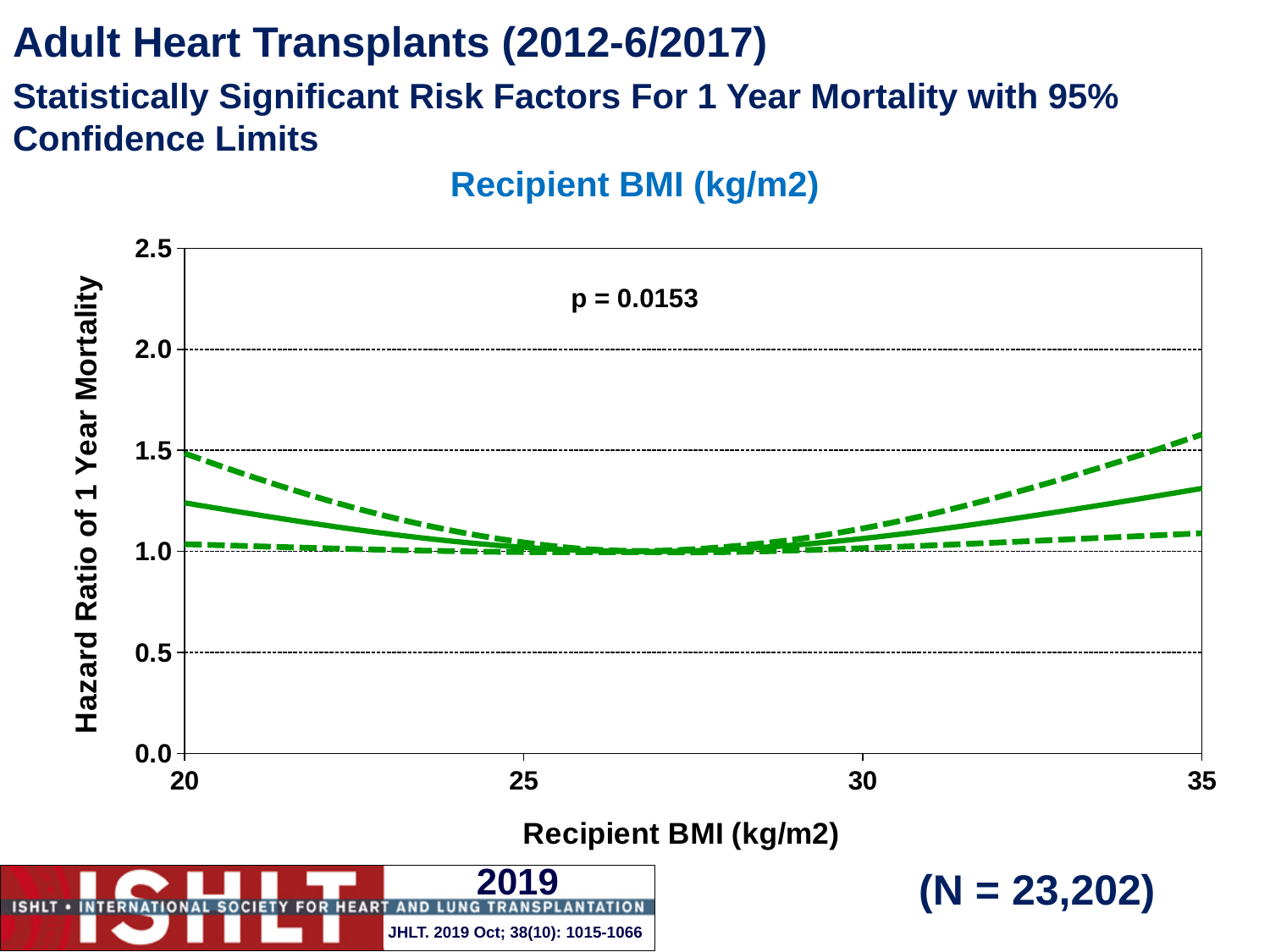
Is the hazard ratio (solid line) at a recipient BMI of 25 greater or less than 1.5? less What kind of chart is shown on the slide? Line chart How many lines are plotted on the chart? 3 Is the hazard ratio (solid line) at a recipient BMI of 35 greater or less than 1.5? less Does the hazard ratio (solid line) rise or fall as recipient BMI increases from 30 to 35? rise How many tick labels are shown on the x axis? 4 What p-value is printed on the chart? p = 0.0153 Does the hazard ratio (solid line) rise or fall as recipient BMI increases from 20 to 25? fall What is the sample size (N) shown on the slide? N = 23,202 What is the label of the y axis? Hazard Ratio of 1 Year Mortality Is the hazard ratio (solid line) at a recipient BMI of 20 greater or less than 1.0? greater What is the title of the chart? Recipient BMI (kg/m2)